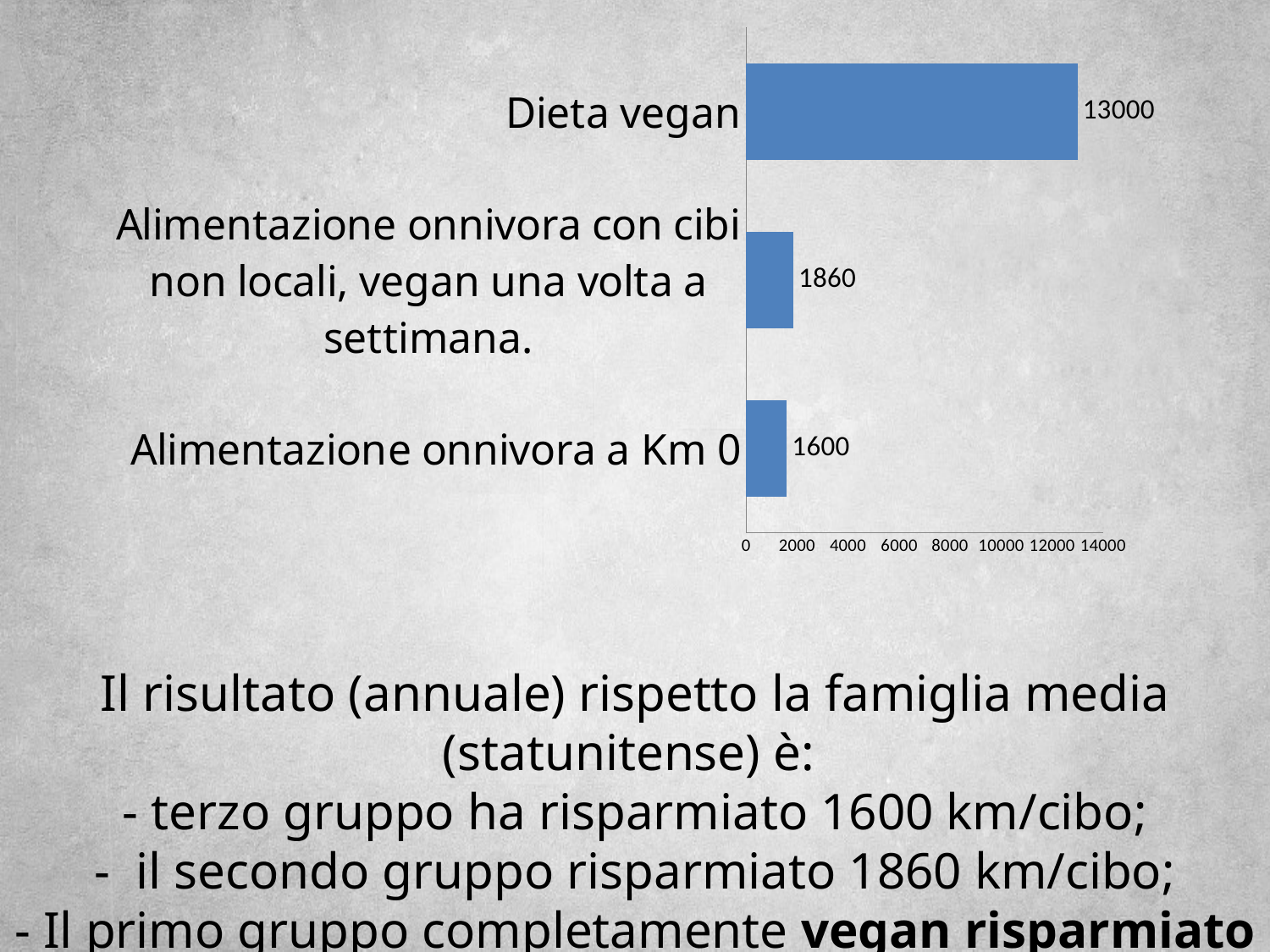
What kind of chart is shown on the slide? bar chart What is the maximum value shown on the horizontal axis? 14000 What is the value for Alimentazione onnivora con cibi non locali, vegan una volta a settimana? 1860 Is the value for Dieta vegan greater or less than 12000? greater Which is larger: the value for Dieta vegan or the value for Alimentazione onnivora con cibi non locali, vegan una volta a settimana? Dieta vegan What is the difference between the value for Alimentazione onnivora con cibi non locali, vegan una volta a settimana and the value for Alimentazione onnivora a Km 0? 260 Which category has the highest value? Dieta vegan Which category has the lowest value? Alimentazione onnivora a Km 0 What is the value for Alimentazione onnivora a Km 0? 1600 What is the difference between the value for Dieta vegan and the value for Alimentazione onnivora a Km 0? 11400 How many categories are shown in the chart? 3 What is the value for Dieta vegan? 13000